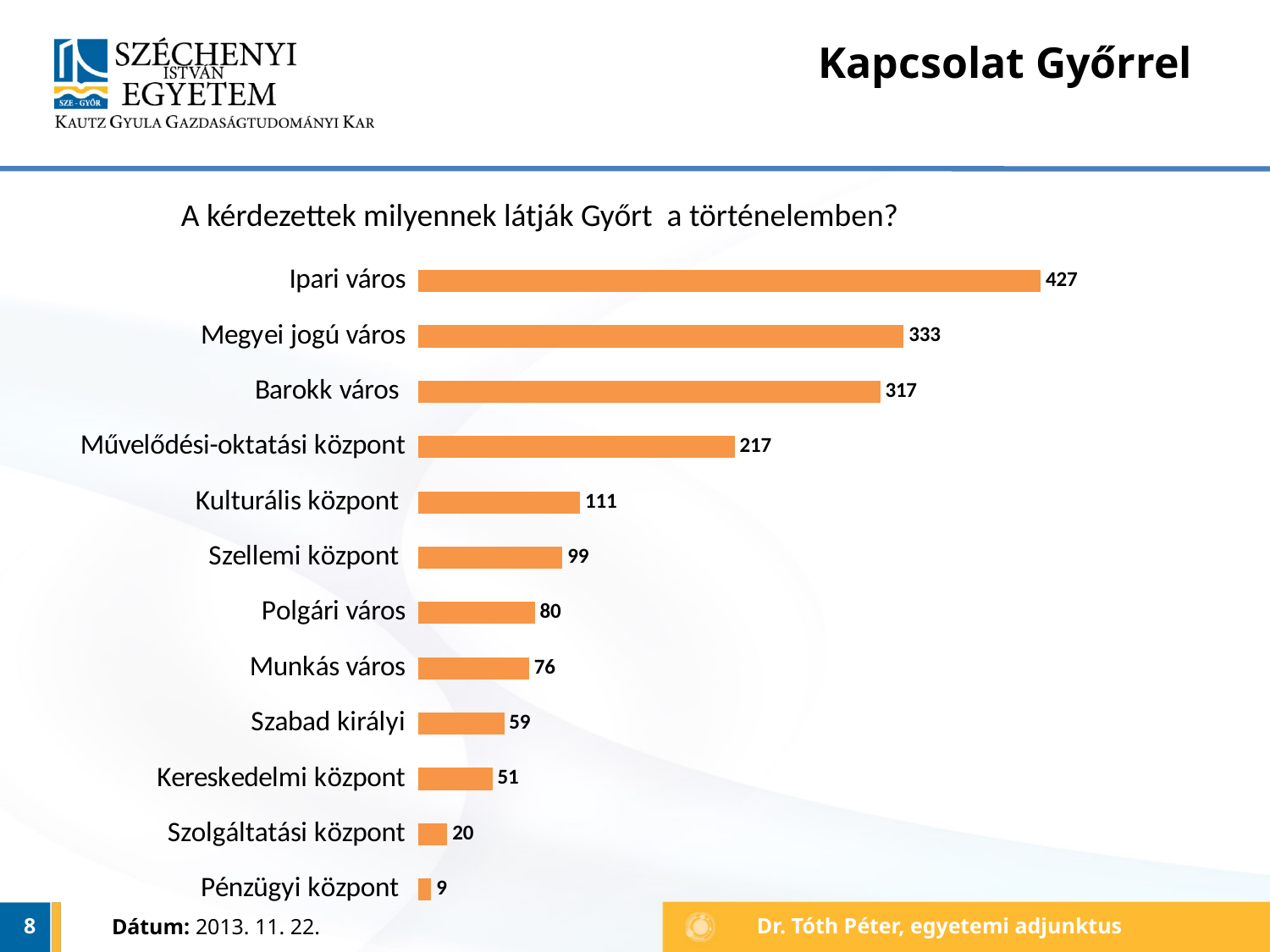
What is the difference between the values for Megyei jogú város and Barokk város? 16 Which is larger, the value for Polgári város or the value for Munkás város? Polgári város What is the value for Szolgáltatási központ? 20 What is the value for Ipari város? 427 Which is larger, the value for Szellemi központ or the value for Kereskedelmi központ? Szellemi központ Which category has the lowest value? Pénzügyi központ What is the difference between the values for Ipari város and Kulturális központ? 316 What is the title of the chart? A kérdezettek milyennek látják Győrt a történelemben? What is the value for Művelődési-oktatási központ? 217 Which category has the highest value? Ipari város How many categories are shown in the chart? 12 What kind of chart is shown on the slide? Bar chart